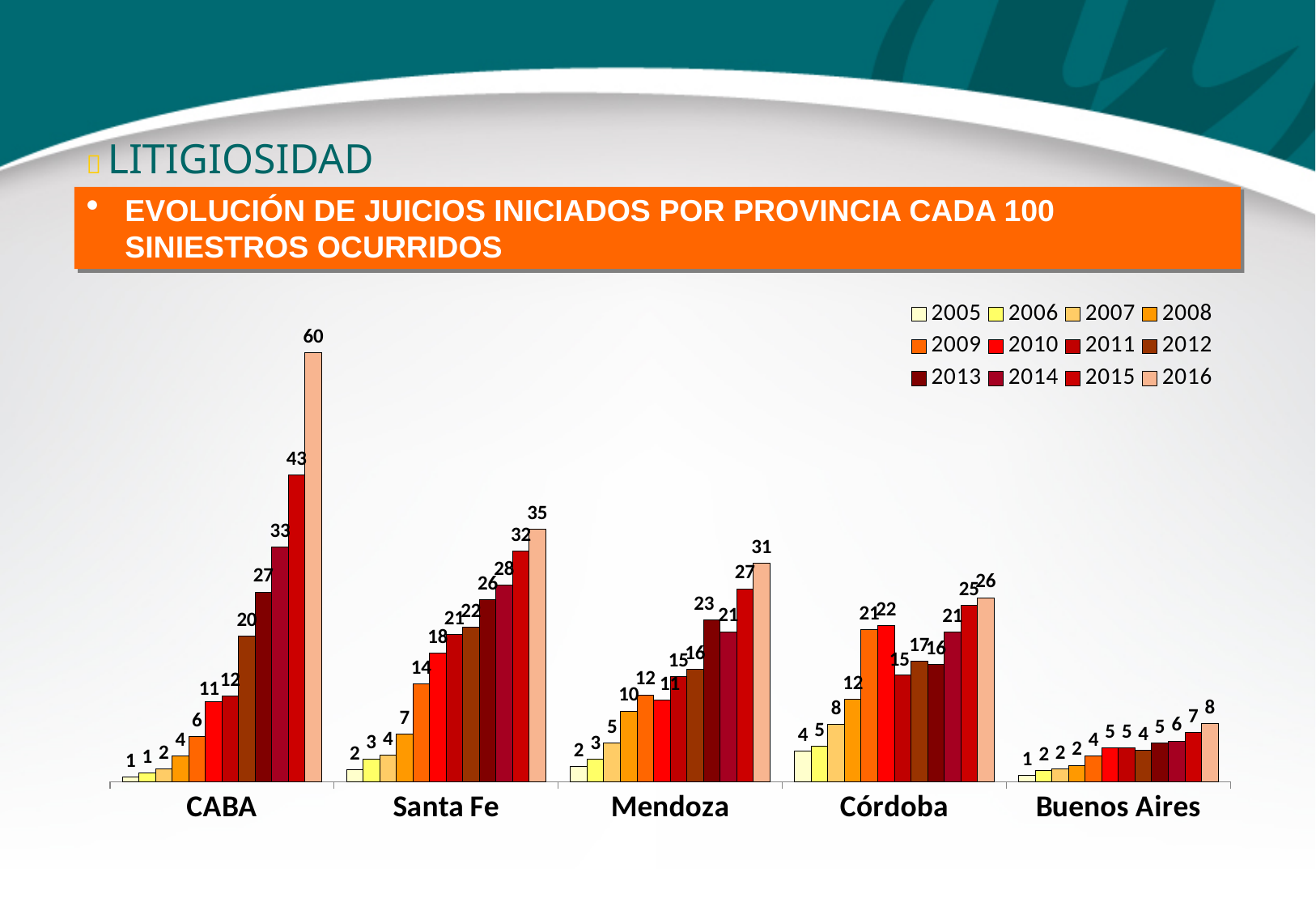
What is the difference between the CABA values for 2016 and 2015? 17 How many provinces are shown on the x axis? 5 Which province has the lowest value in 2016? Buenos Aires What is the value for CABA in 2016? 60 What is the value for Córdoba in 2010? 22 How many series (years) does the legend list? 12 What is the value for Mendoza in 2009? 12 What is the value for Santa Fe in 2016? 35 Do the values for CABA rise or fall from 2005 to 2016? Rise Which province has the highest value in 2016? CABA Which is larger, the 2016 value for Santa Fe or the 2016 value for Mendoza? Santa Fe What kind of chart is shown on the slide? Bar chart